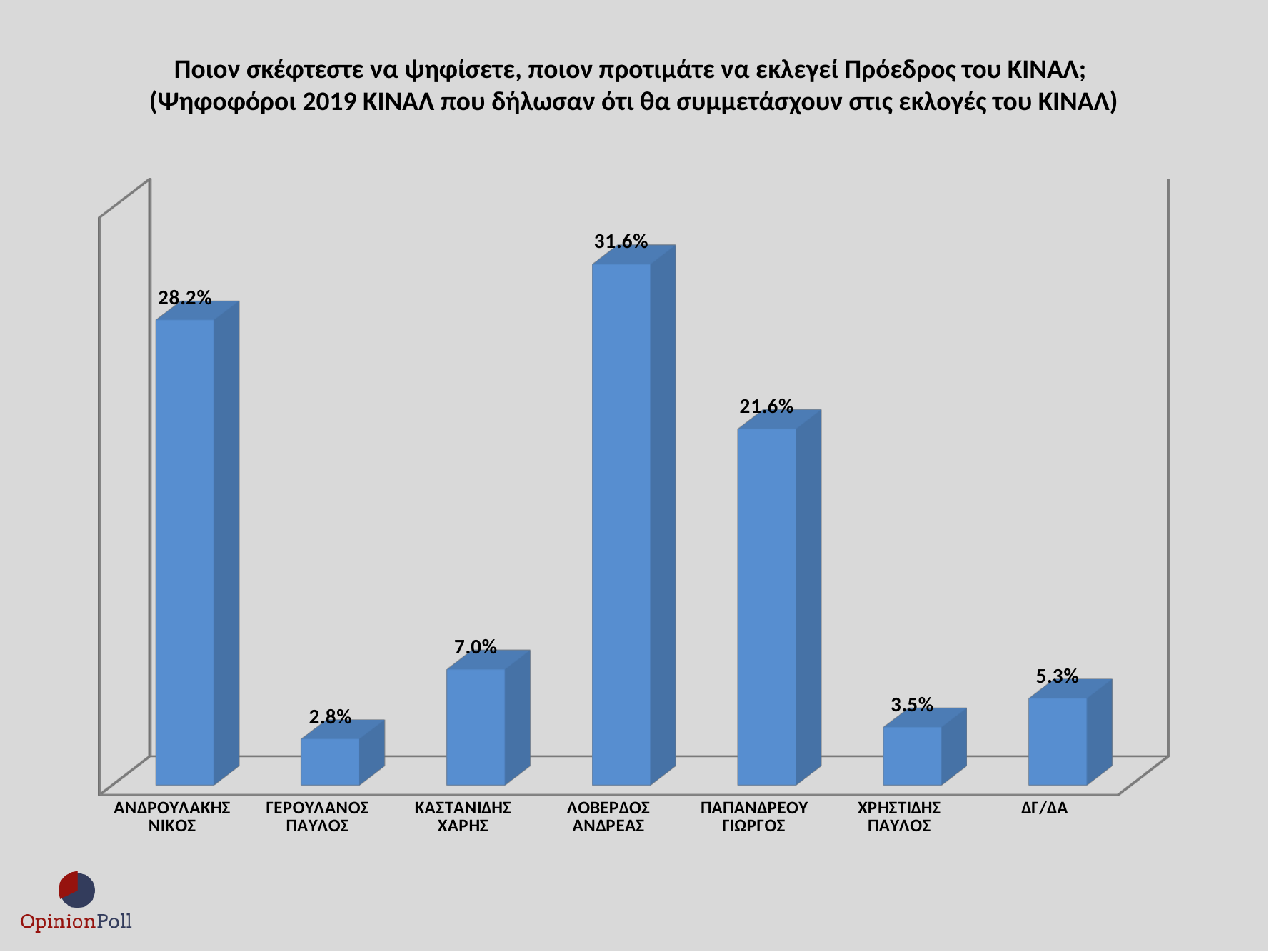
What is the value for ΠΑΠΑΝΔΡΕΟΥ ΓΙΩΡΓΟΣ? 21.6% What is the value for ΔΓ/ΔΑ? 5.3% What is the difference between the values for ΚΑΣΤΑΝΙΔΗΣ ΧΑΡΗΣ and ΧΡΗΣΤΙΔΗΣ ΠΑΥΛΟΣ? 3.5% What is the difference between the values for ΛΟΒΕΡΔΟΣ ΑΝΔΡΕΑΣ and ΑΝΔΡΟΥΛΑΚΗΣ ΝΙΚΟΣ? 3.4% What is the value for ΛΟΒΕΡΔΟΣ ΑΝΔΡΕΑΣ? 31.6% What is the value for ΑΝΔΡΟΥΛΑΚΗΣ ΝΙΚΟΣ? 28.2% What kind of chart is shown on the slide? Bar chart Which category has the lowest value? ΓΕΡΟΥΛΑΝΟΣ ΠΑΥΛΟΣ How many categories are shown on the chart? 7 Which is larger, the value for ΔΓ/ΔΑ or the value for ΧΡΗΣΤΙΔΗΣ ΠΑΥΛΟΣ? ΔΓ/ΔΑ Which category has the highest value? ΛΟΒΕΡΔΟΣ ΑΝΔΡΕΑΣ Which is larger, the value for ΠΑΠΑΝΔΡΕΟΥ ΓΙΩΡΓΟΣ or the value for ΑΝΔΡΟΥΛΑΚΗΣ ΝΙΚΟΣ? ΑΝΔΡΟΥΛΑΚΗΣ ΝΙΚΟΣ